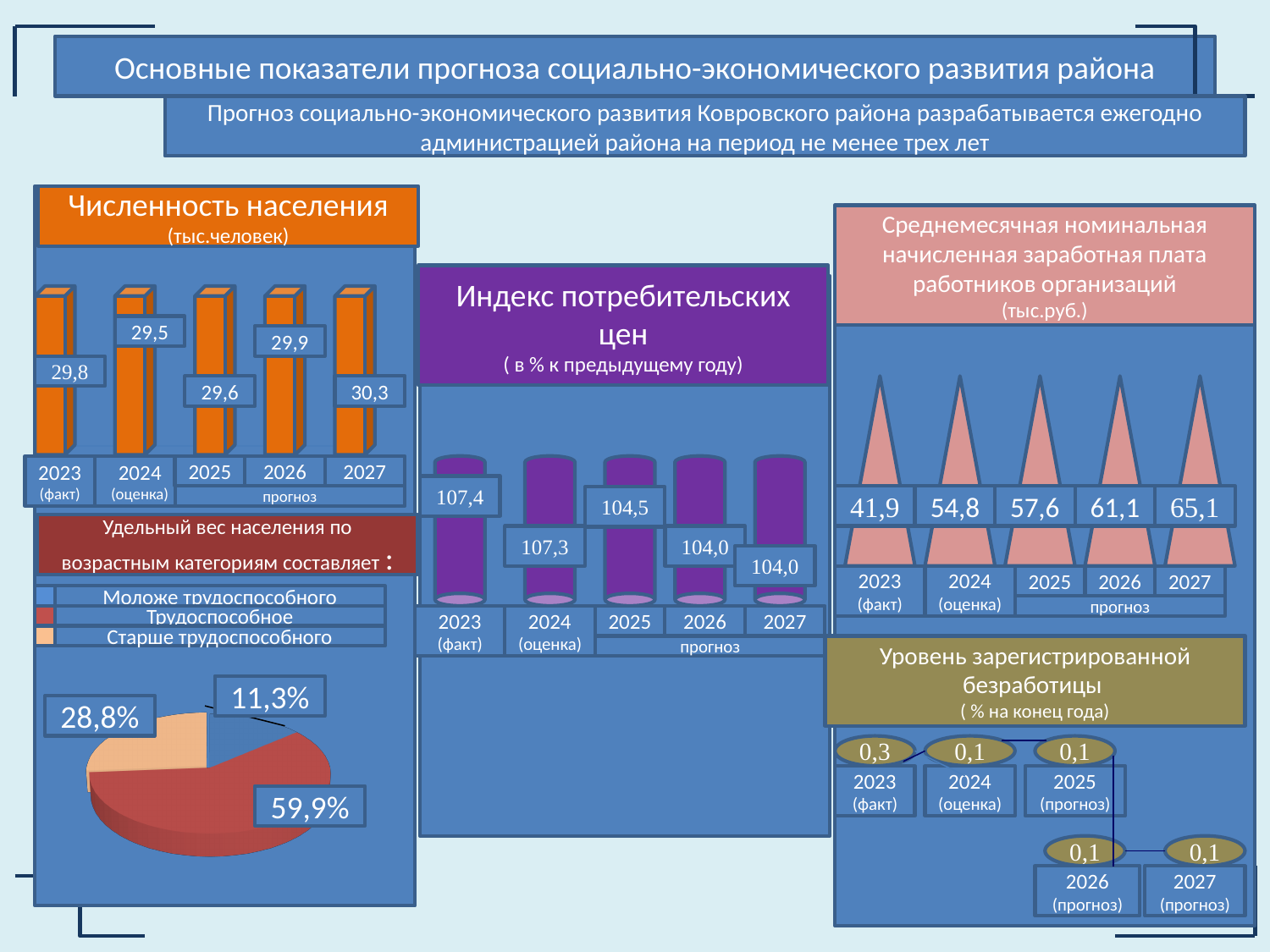
In the 'Численность населения' chart, what is the difference between the 2027 and 2023 values? 0,5 In the 'Численность населения' chart, which year has the lowest value? 2024 In the 'Индекс потребительских цен' chart, do the values rise or fall from 2023 to 2027? fall In the 'Среднемесячная номинальная начисленная заработная плата' chart, what is the value for 2024? 54,8 In the 'Среднемесячная номинальная начисленная заработная плата' chart, what is the difference between the 2027 and 2023 values? 23,2 In the 'Индекс потребительских цен' chart, which year has the highest value? 2023 In the 'Индекс потребительских цен' chart, what is the value for 2025? 104,5 In the 'Уровень зарегистрированной безработицы' chart, what is the value for 2023? 0,3 In the pie chart of population by age category, what share is 'Трудоспособное'? 59,9% In the pie chart of population by age category, which category has the smallest share? Моложе трудоспособного In the 'Среднемесячная номинальная начисленная заработная плата' chart, how many years are shown? 5 In the 'Численность населения' chart, what is the value for 2027? 30,3